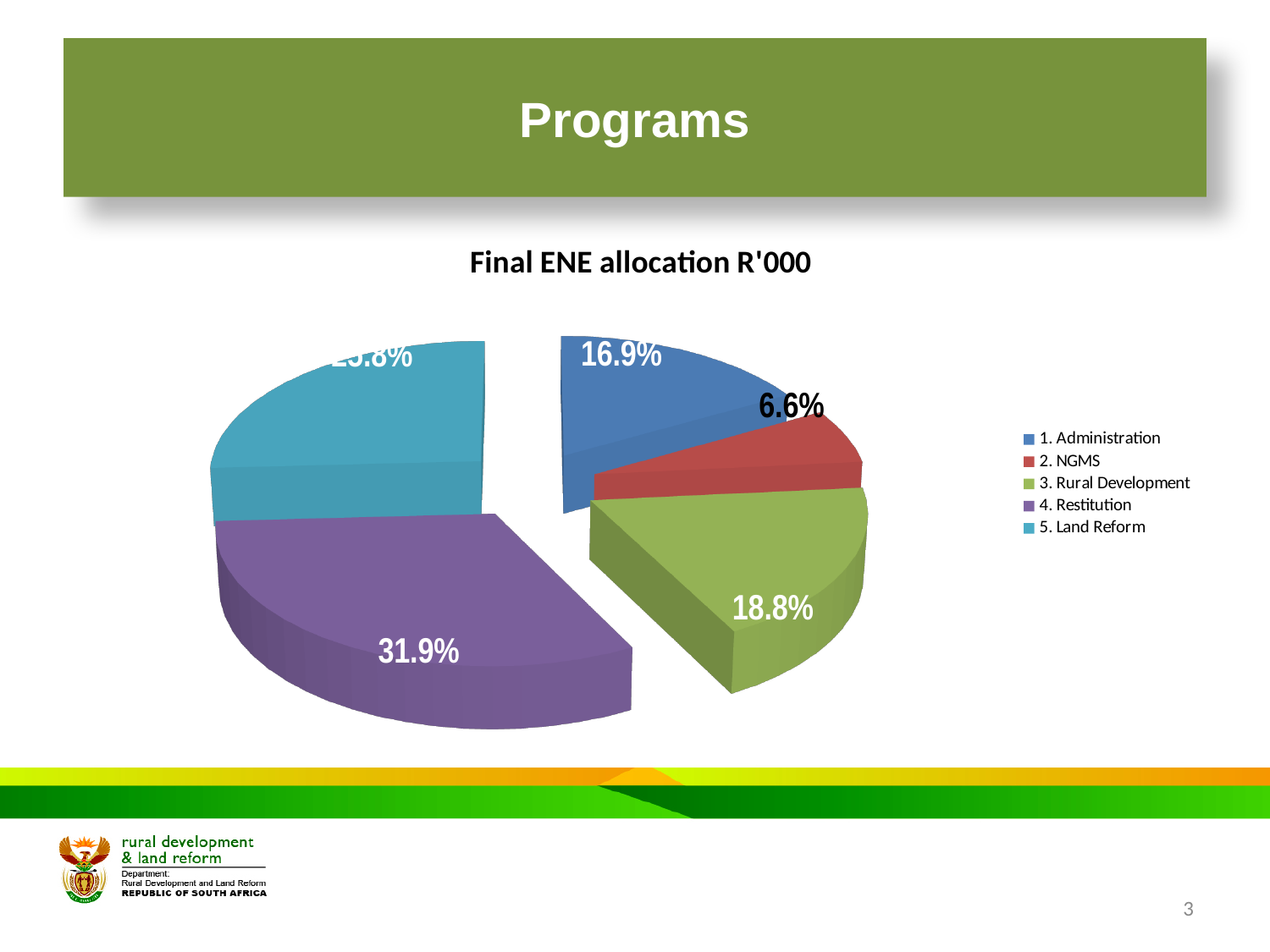
Which has the larger share: 1. Administration or 3. Rural Development? 3. Rural Development How many programs are shown in the pie chart? 5 Which program has the largest share of the Final ENE allocation? 4. Restitution What share does 3. Rural Development have in the Final ENE allocation pie chart? 18.8% Which program has the smallest share of the Final ENE allocation? 2. NGMS What is the title of the chart? Final ENE allocation R'000 What percentage of the pie is 2. NGMS? 6.6% What colour is the 4. Restitution slice in the pie chart? Purple What share of the Final ENE allocation goes to 1. Administration? 16.9% What percentage is shown for 4. Restitution? 31.9% What type of chart is shown on the slide? Pie chart By how many percentage points does the 4. Restitution share exceed the 3. Rural Development share? 13.1 percentage points